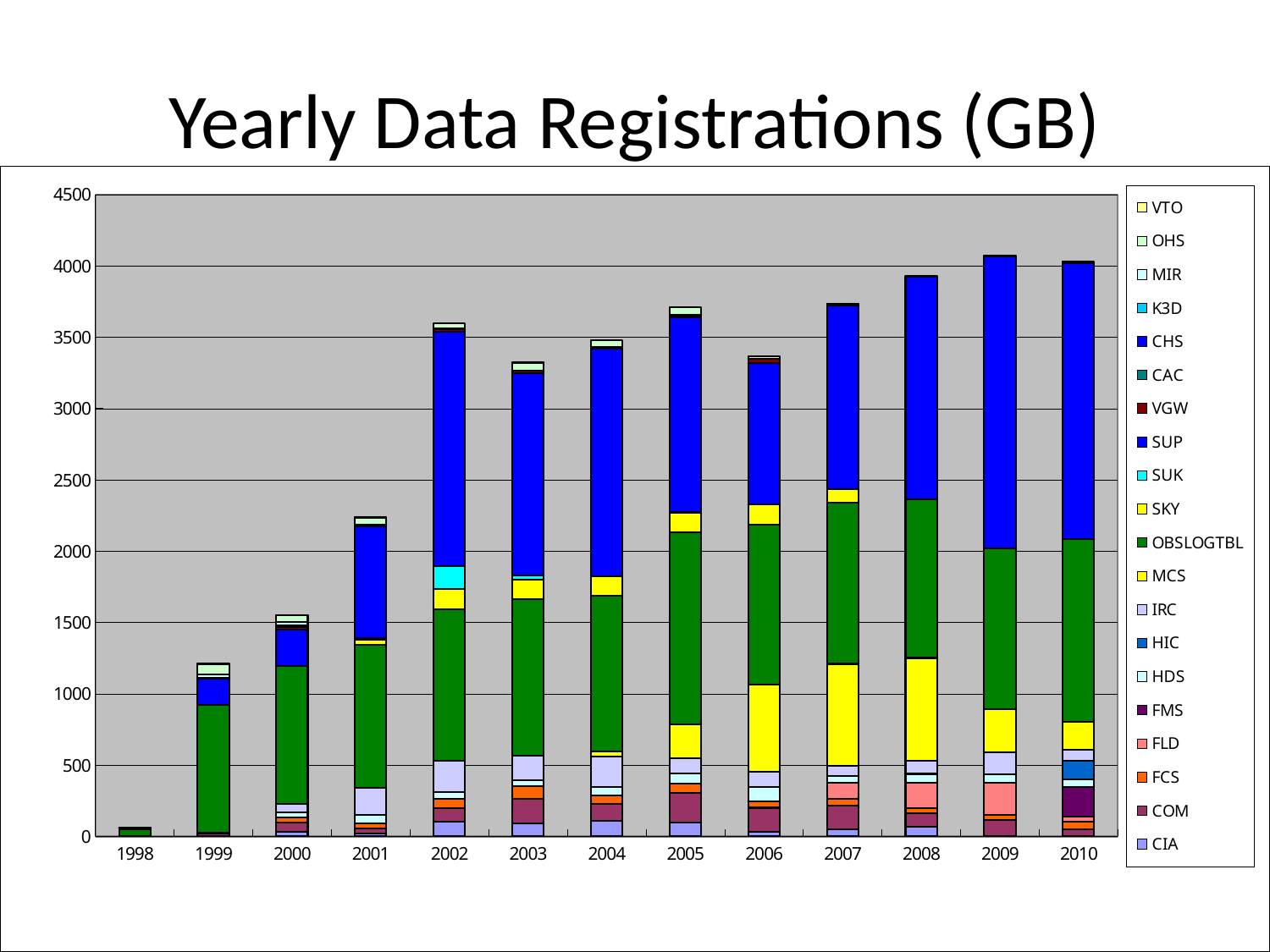
How many years are shown on the x axis of the chart? 13 Is the total for 2002 greater or less than 3500? greater What kind of chart is shown on the slide? Stacked bar chart What is the title of the chart? Yearly Data Registrations (GB) Is the total for 1998 greater or less than 500? less Is the total for 2009 greater or less than 4000? greater Which year has the lowest total data registrations? 1998 Overall, do the yearly totals rise or fall from 1998 to 2010? rise How many series does the legend list? 20 Which year has the larger total, 2002 or 2003? 2002